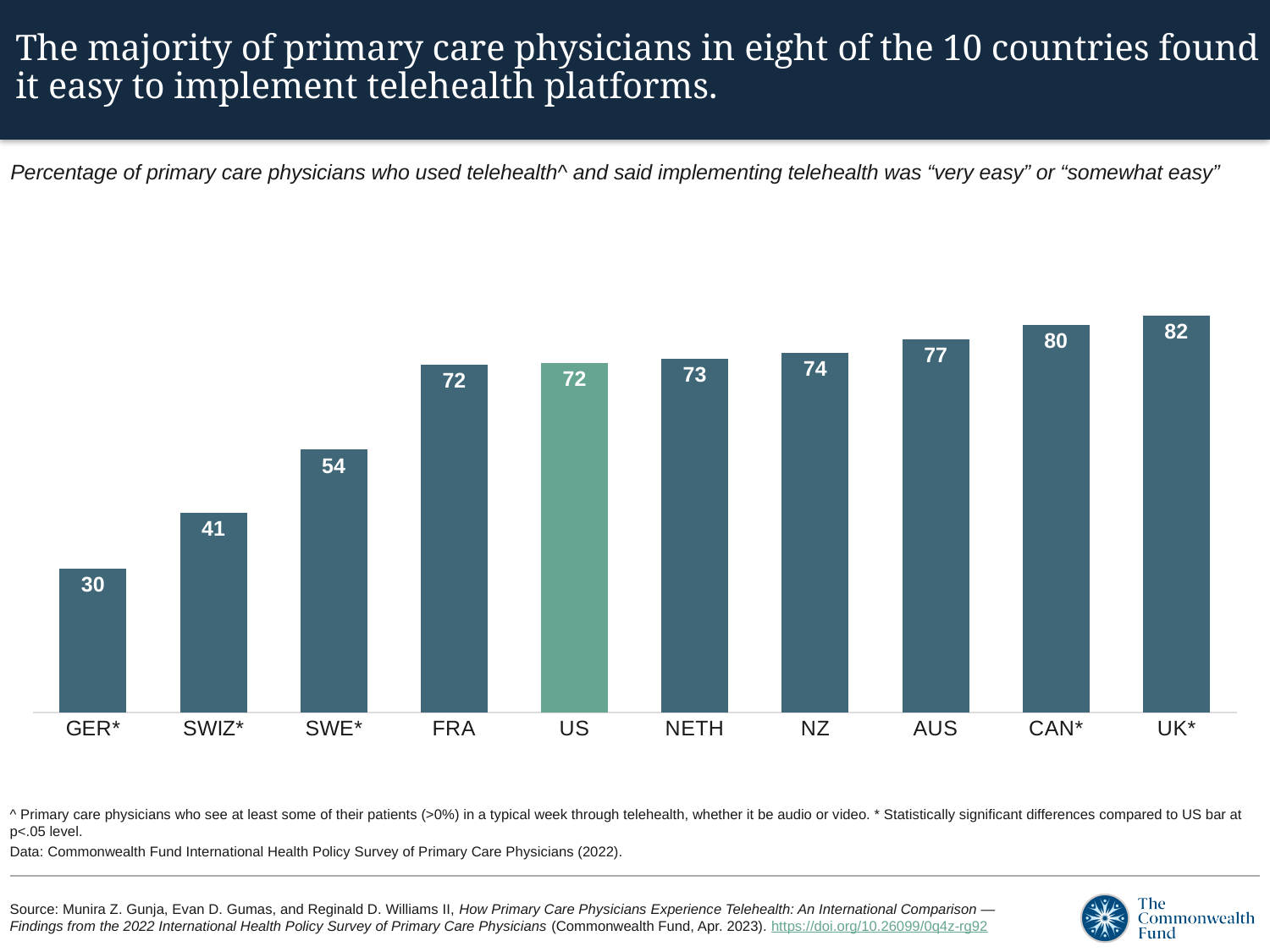
Do the values rise or fall from left to right across the chart? Rise What kind of chart is shown on the slide? Bar chart Which is larger, the value for SWIZ* or the value for SWE*? SWE* What is the value for GER*? 30 What is the value for AUS? 77 What is the difference between the values for UK* and GER*? 52 How many countries are shown in the chart? 10 Which country has the highest value? UK* What is the difference between the values for CAN* and SWE*? 26 What is the value for the US? 72 Which bar is shown in a different colour (green) from the others? US Which country has the lowest value? GER*